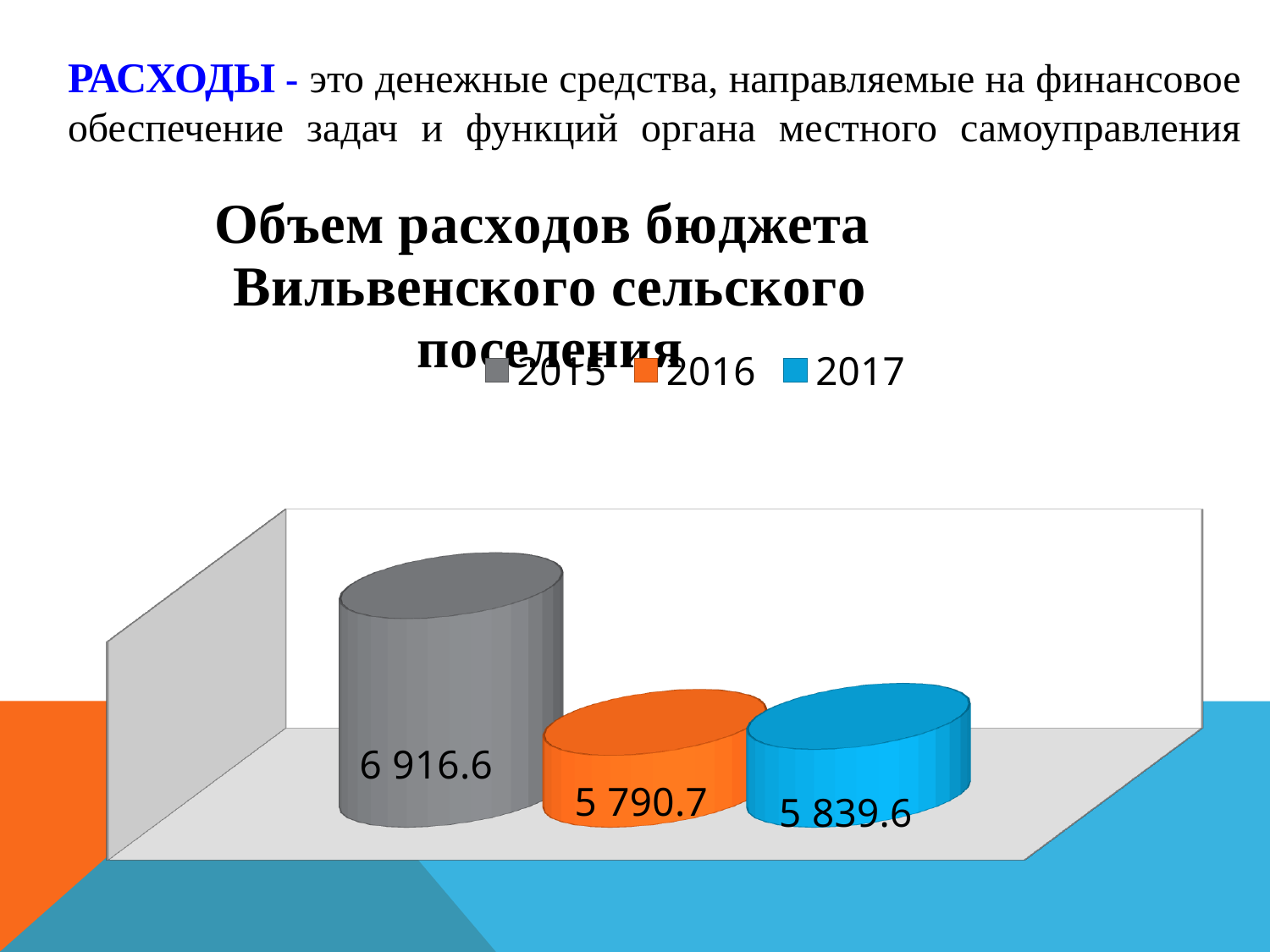
Which year has the lowest value on the chart? 2016 What is the difference between the values for 2017 and 2016? 48.9 What is the value for 2015 on the chart? 6 916.6 What is the value for 2016 on the chart? 5 790.7 Does the value fall or rise from 2015 to 2016? Fall Which is larger, the value for 2016 or the value for 2017? 2017 Which year has the highest value on the chart? 2015 What is the difference between the values for 2015 and 2016? 1 125.9 What kind of chart is shown on the slide? Bar chart What colour is the bar for 2017? Blue What is the value for 2017 on the chart? 5 839.6 How many series does the legend list? 3